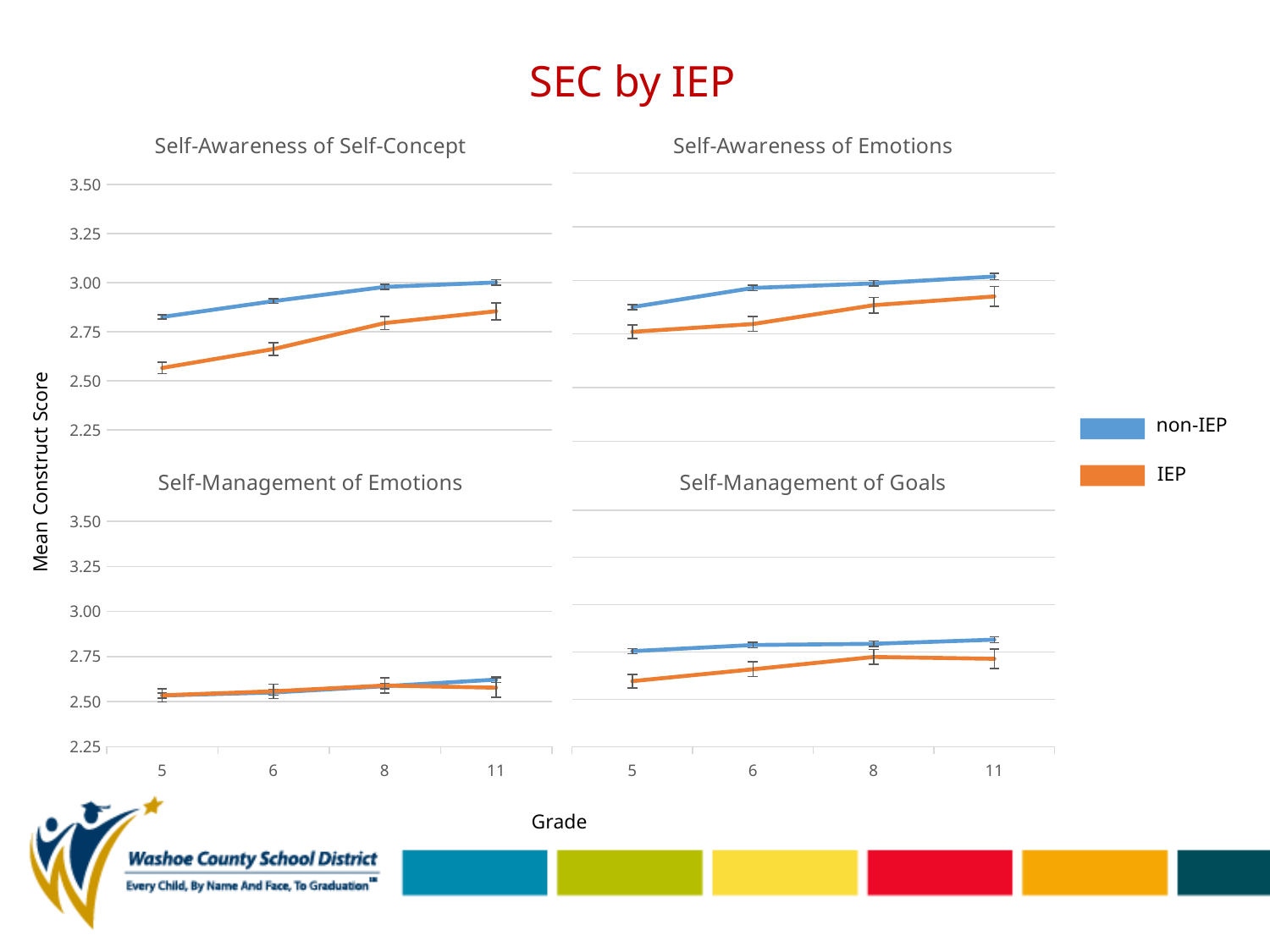
In the Self-Awareness of Emotions chart, does the IEP line rise or fall from grade 5 to grade 11? rise How many grade points are plotted on the x axis of the Self-Management of Goals chart? 4 In the Self-Management of Goals chart, which series has the larger value at grade 5, non-IEP or IEP? non-IEP What kind of chart is the Self-Awareness of Self-Concept chart? line chart In the Self-Management of Emotions chart, is the non-IEP value at grade 11 greater or less than 2.50? greater In the Self-Awareness of Self-Concept chart, is the IEP value at grade 5 greater or less than 2.75? less What is the label of the shared y axis? Mean Construct Score Which series is shown in orange in the legend? IEP How many series does the legend list? 2 In the Self-Awareness of Self-Concept chart, does the non-IEP line rise or fall from grade 5 to grade 11? rise In the Self-Awareness of Self-Concept chart, which series has the larger value at grade 5, non-IEP or IEP? non-IEP In the Self-Management of Goals chart, is the non-IEP value at grade 11 greater or less than 2.75? greater